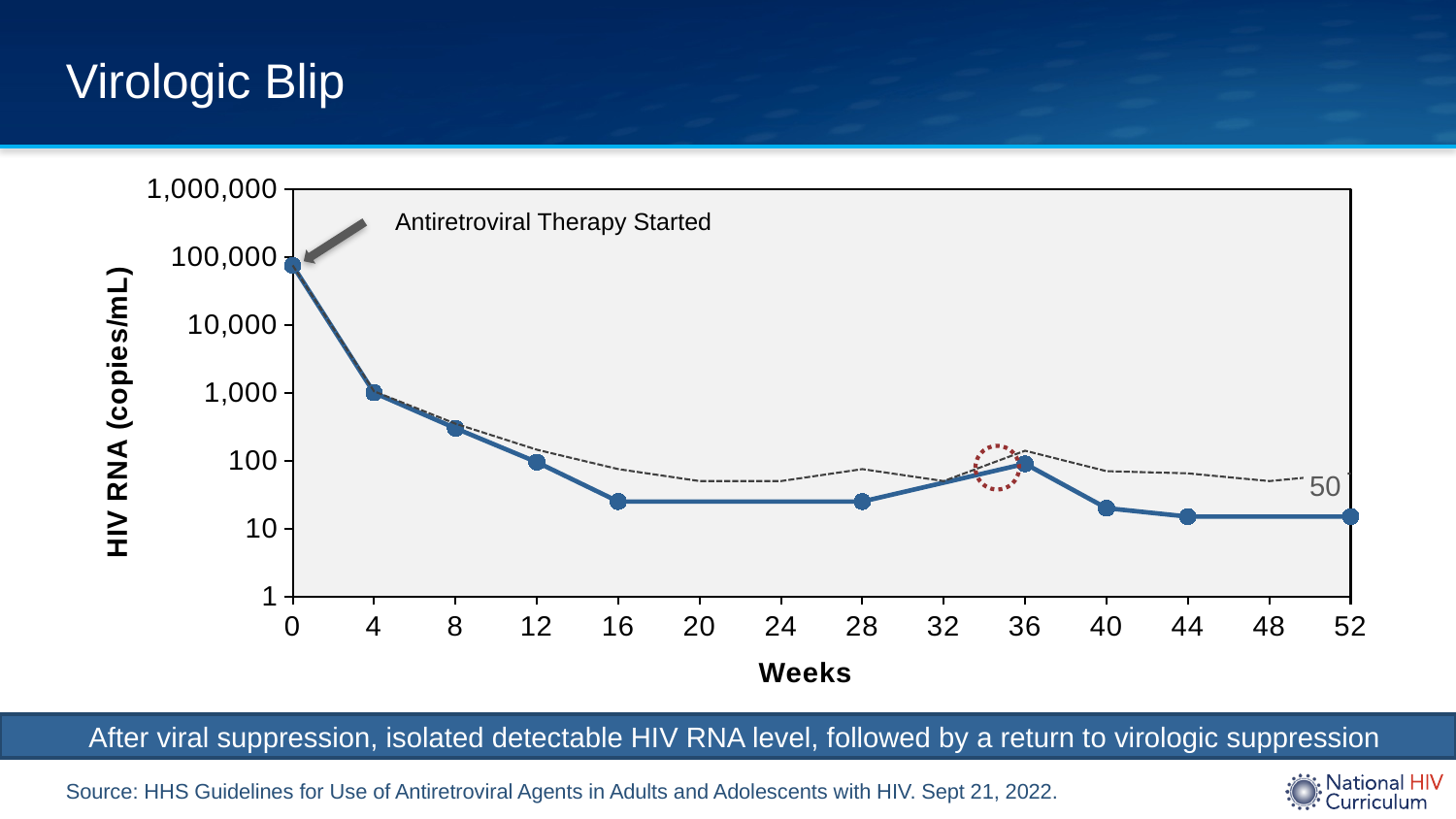
Is the HIV RNA value at week 16 greater or less than 100? less What is the title of the chart's x axis? Weeks At which week is the HIV RNA level highest? 0 Does the HIV RNA level rise or fall between week 0 and week 16? fall Is the HIV RNA value at week 8 greater or less than 100? greater Is the HIV RNA value at week 52 greater or less than 10? greater How many data points are plotted on the solid line? 10 Which has the higher HIV RNA value, week 28 or week 36? week 36 What is the title of the chart's y axis? HIV RNA (copies/mL) What kind of chart is shown on the slide? line chart